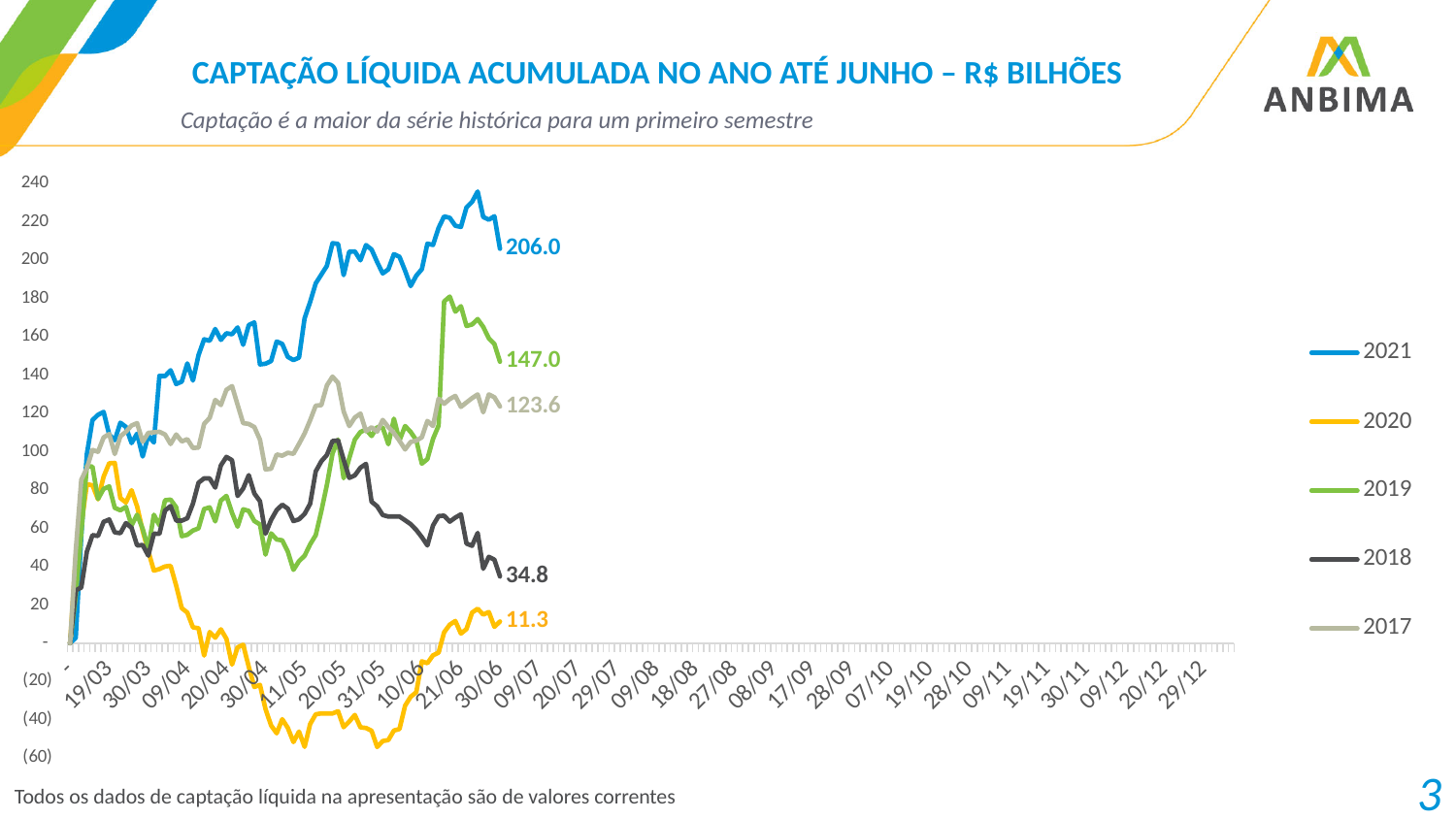
What is the final labelled value for the 2017 series? 123.6 What is the final labelled value for the 2020 series? 11.3 What is the difference between the final labelled values of the 2021 and 2019 series? 59.0 Which series has the highest final labelled value? 2021 What kind of chart is shown on the slide? Line chart What is the final labelled value for the 2018 series? 34.8 How many series does the legend list? 5 What is the final labelled value for the 2021 series? 206.0 What is the final labelled value for the 2019 series? 147.0 What is the title of the chart? CAPTAÇÃO LÍQUIDA ACUMULADA NO ANO ATÉ JUNHO – R$ BILHÕES Which series ends higher, 2017 or 2018? 2017 Which series has the lowest final labelled value? 2020